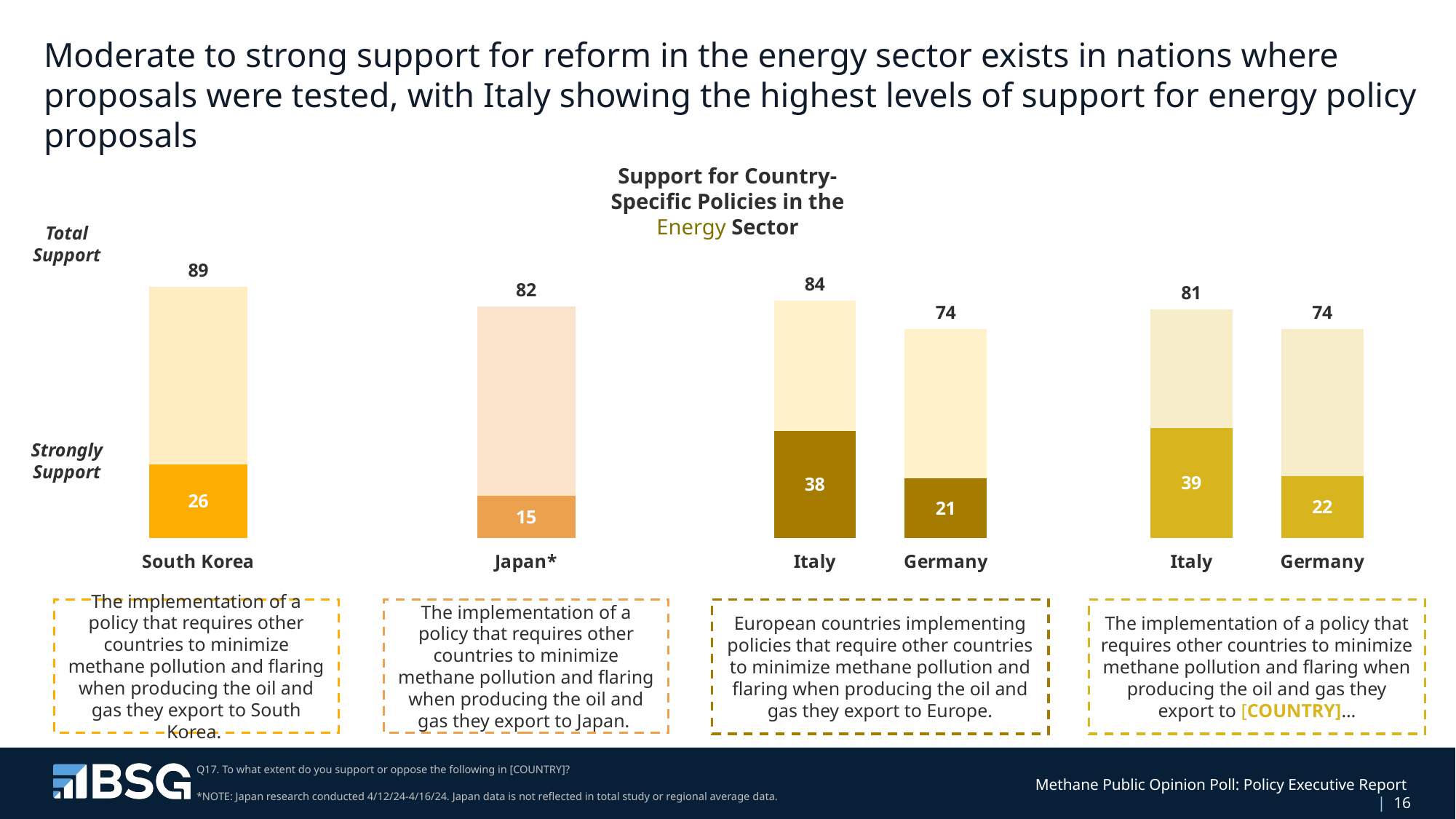
Which country bar has the lowest strongly support value on the chart? Japan* What is the title of the chart? Support for Country-Specific Policies in the Energy Sector Which country bar has the highest total support value on the chart? South Korea What kind of chart is shown on the slide? Stacked bar chart What is the strongly support value for Japan*? 15 What is the total support value for South Korea? 89 How many country bars are shown on the chart? 6 What is the difference between the strongly support values for South Korea and Japan*? 11 In the group about European countries implementing policies (third group from the left), what is the strongly support value for Italy? 38 In the rightmost group, which has the larger strongly support value, Italy or Germany? Italy In the third group from the left (European countries policy), what is the difference between the total support values for Italy and Germany? 10 In the rightmost group (policy about oil and gas exported to [COUNTRY]), what is the total support value for Germany? 74